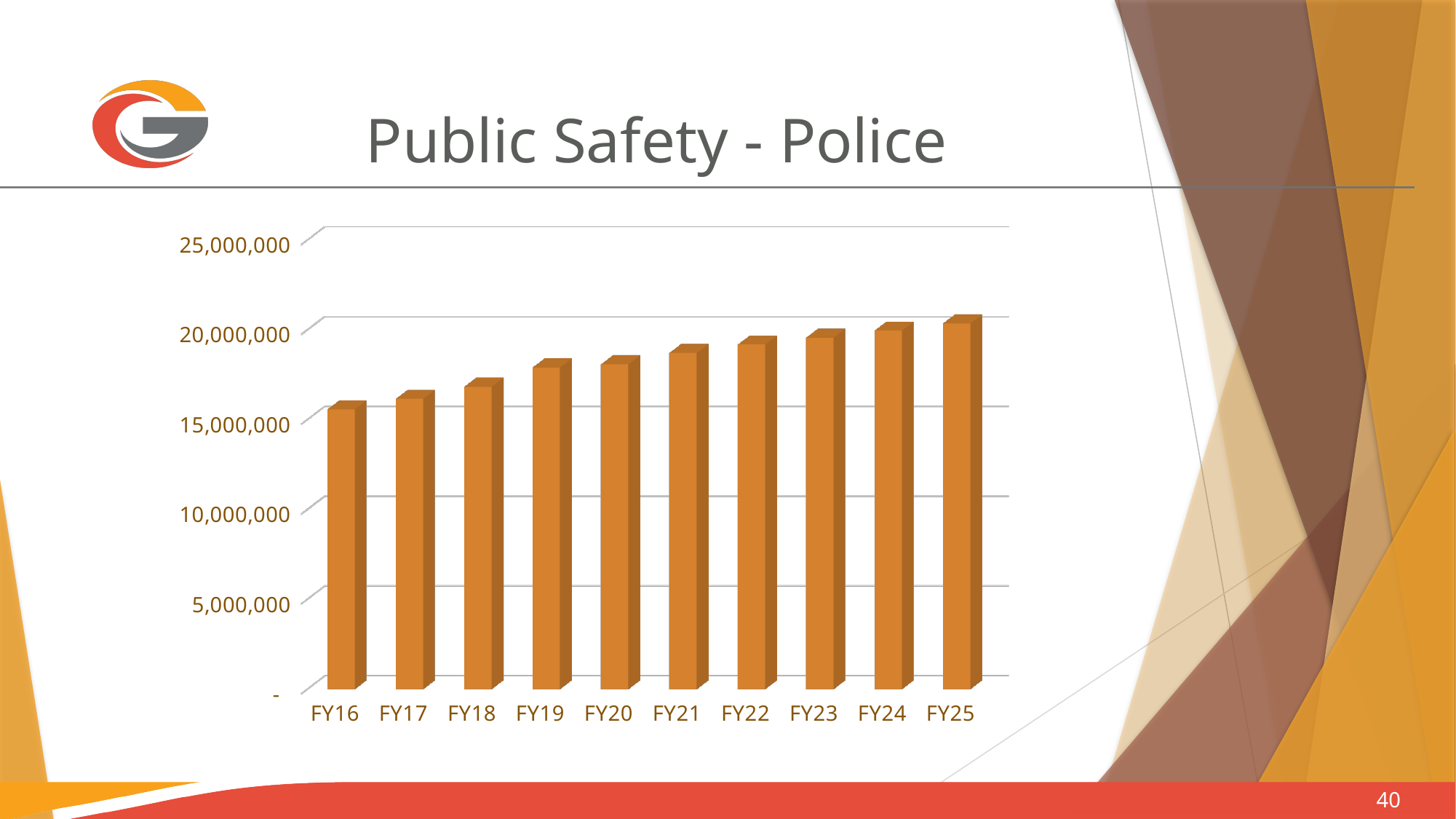
Is the value for FY22 greater or less than 20,000,000? less Is the value for FY16 greater or less than 15,000,000? greater What is the title of the slide containing the chart? Public Safety - Police Is the value for FY19 greater or less than 15,000,000? greater Which is larger, the value for FY18 or the value for FY23? FY23 How many fiscal years are plotted on the chart? 10 What kind of chart is shown on the slide? bar chart Which is larger, the value for FY16 or the value for FY20? FY20 Do the values rise or fall from FY16 to FY25? rise Which fiscal year has the lowest value on the chart? FY16 Which fiscal year has the highest value on the chart? FY25